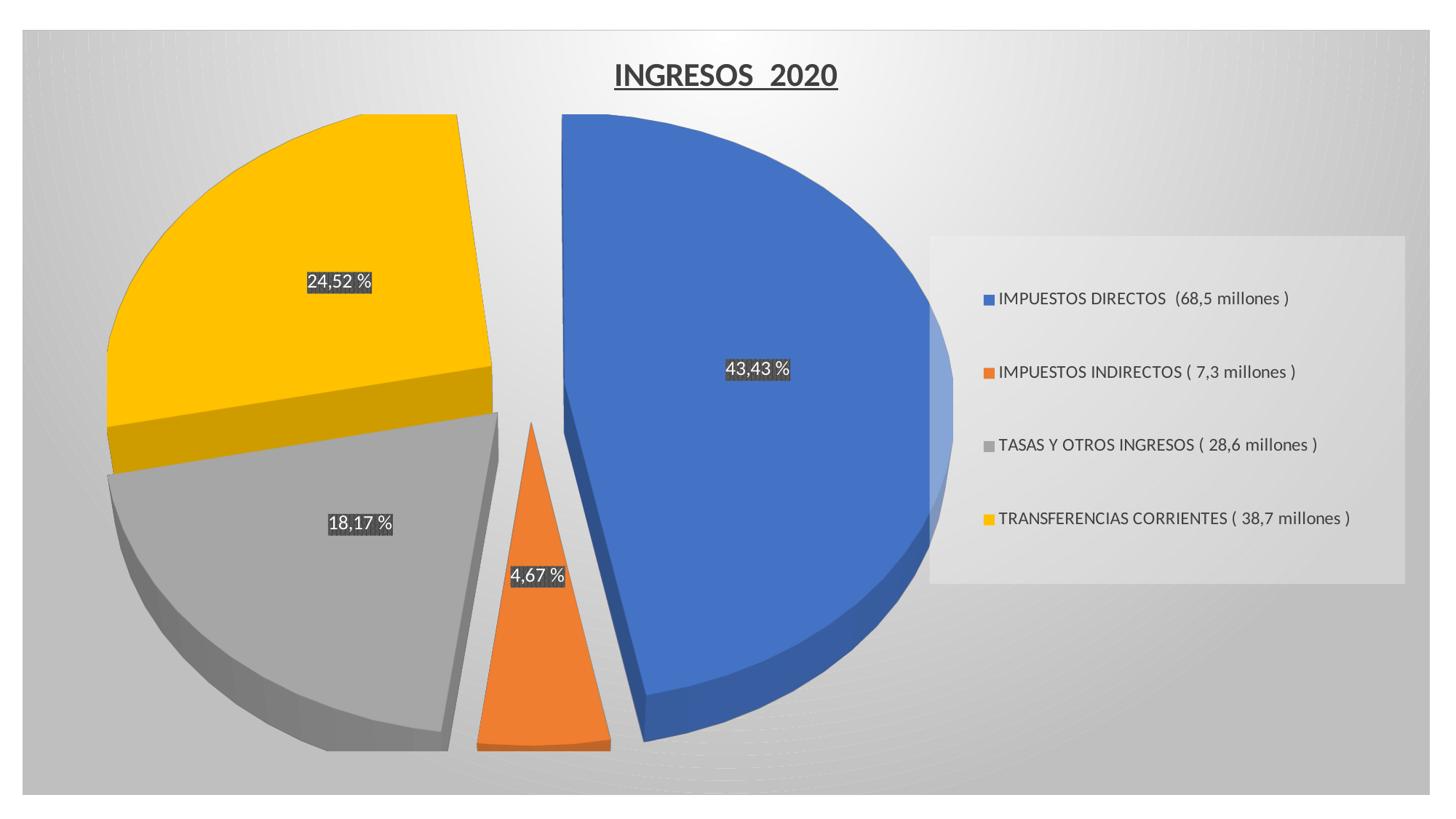
What is the difference in percentage points between the IMPUESTOS DIRECTOS share and the TRANSFERENCIAS CORRIENTES share? 18,91 % Which category has the largest slice of the pie? IMPUESTOS DIRECTOS How many categories does the pie chart show? 4 What percentage share does IMPUESTOS INDIRECTOS have in the pie? 4,67 % What percentage share does IMPUESTOS DIRECTOS have in the pie? 43,43 % What type of chart is shown on the slide? Pie chart Which is larger, the share for TASAS Y OTROS INGRESOS or the share for TRANSFERENCIAS CORRIENTES? TRANSFERENCIAS CORRIENTES What colour is the slice for TRANSFERENCIAS CORRIENTES? Yellow What percentage share does TASAS Y OTROS INGRESOS have in the pie? 18,17 % What is the title of the chart? INGRESOS 2020 Which category has the smallest slice of the pie? IMPUESTOS INDIRECTOS